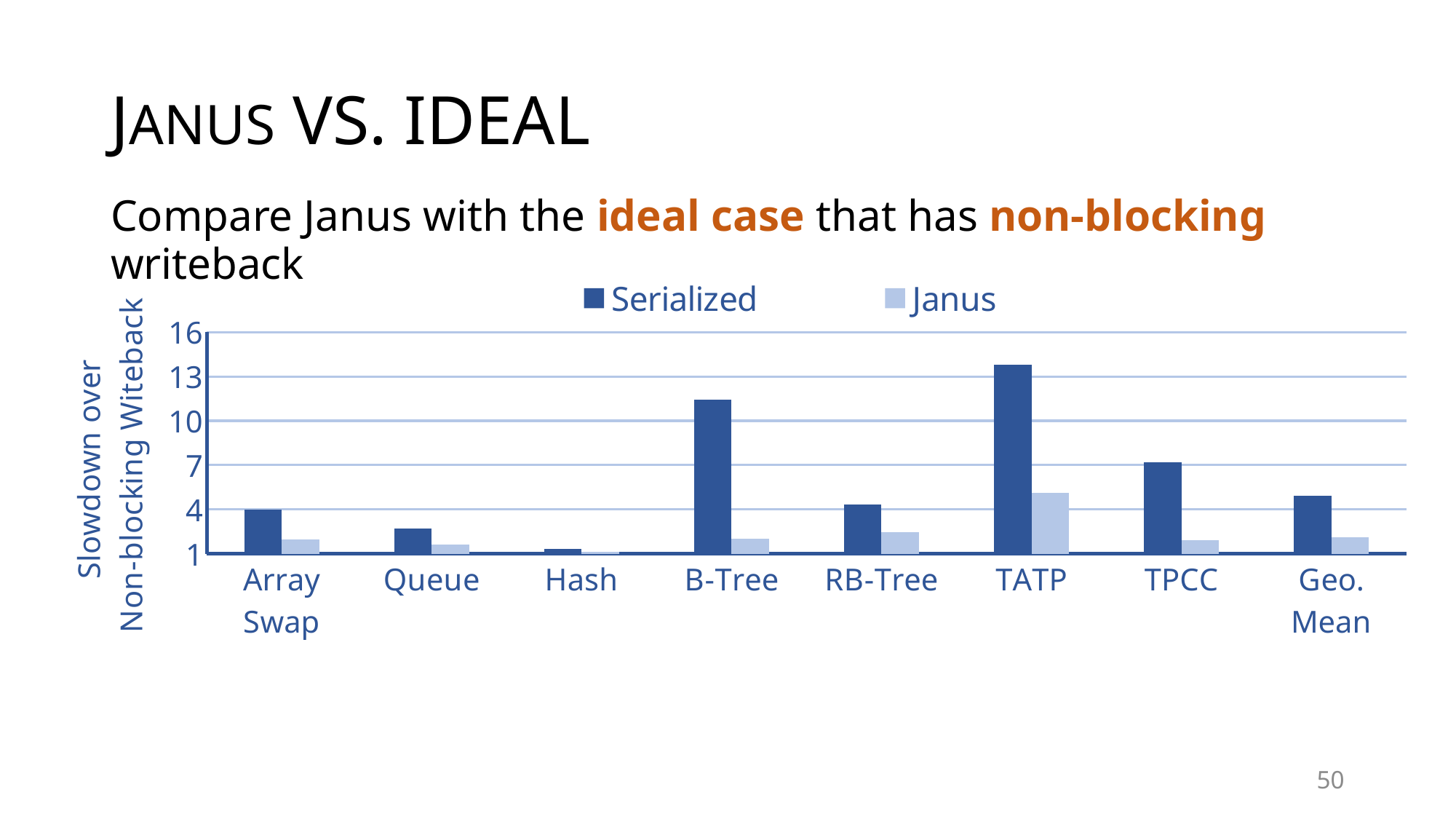
What kind of chart is shown on the slide? bar chart How many categories are shown along the x axis? 8 Which category has the highest Serialized value? TATP Is the Serialized value for B-Tree greater or less than 10? greater Which category has the lowest Serialized value? Hash Which category has the highest Janus value? TATP How many series does the legend list? 2 What are the two series named in the legend? Serialized and Janus Which is larger for B-Tree, the Serialized value or the Janus value? Serialized Is the Janus value for TATP greater or less than 7? less Is the Serialized value for TATP greater or less than 13? greater